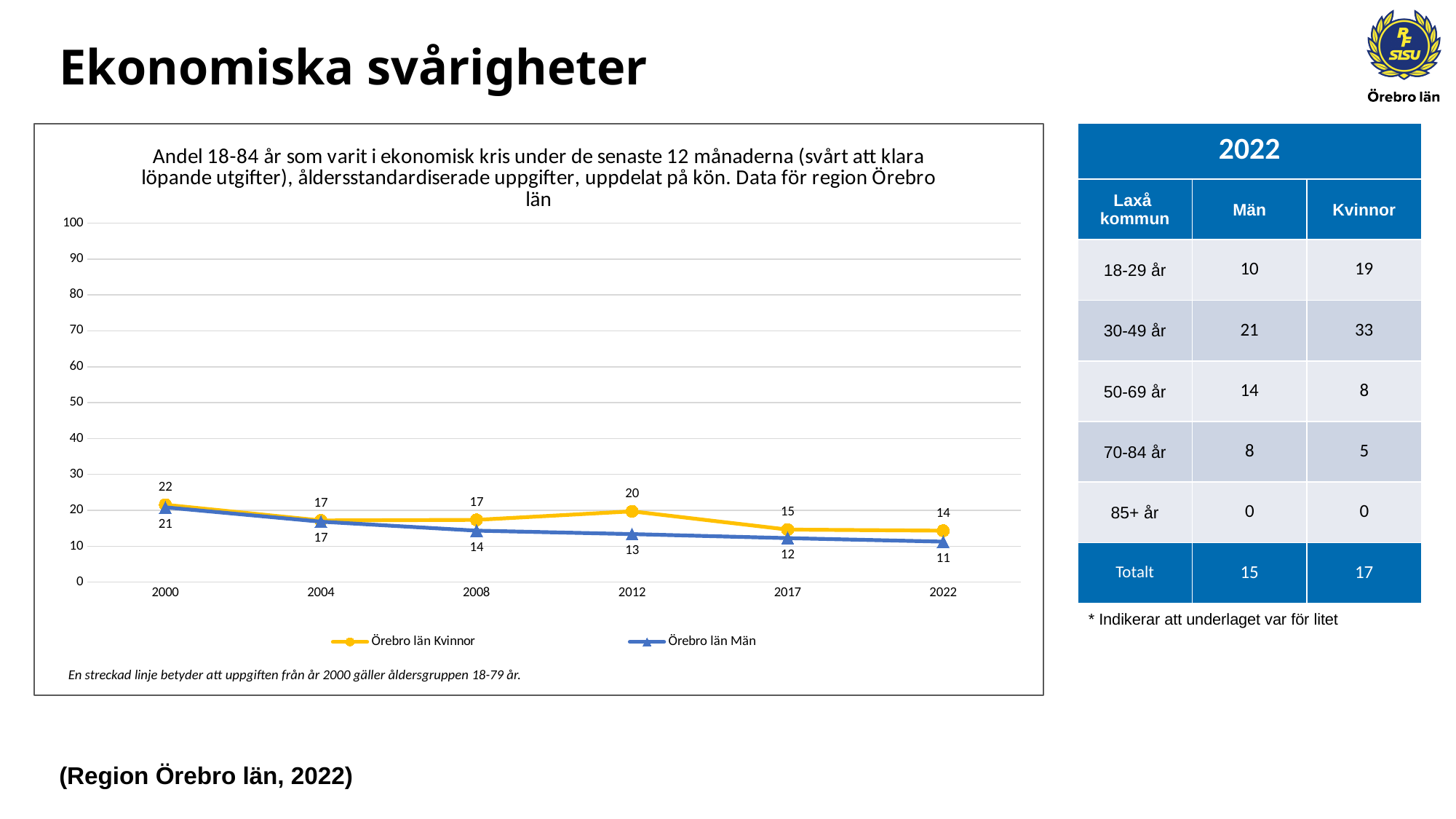
In which year is the value for Örebro län Kvinnor highest? 2000 What is the difference between Örebro län Kvinnor and Örebro län Män in 2012? 7 What is the value for Örebro län Män in 2000? 21 What is the value for Örebro län Kvinnor in 2012? 20 What is the value for Örebro län Män in 2022? 11 Does the value for Örebro län Män rise or fall from 2000 to 2022? fall Which series has the larger value in 2008, Örebro län Kvinnor or Örebro län Män? Örebro län Kvinnor In which year is the value for Örebro län Män lowest? 2022 How many series does the chart legend list? 2 How many years are shown on the x axis of the chart? 6 Is the value for Örebro län Kvinnor in 2000 greater or less than 30? less What kind of chart is shown on the slide? line chart